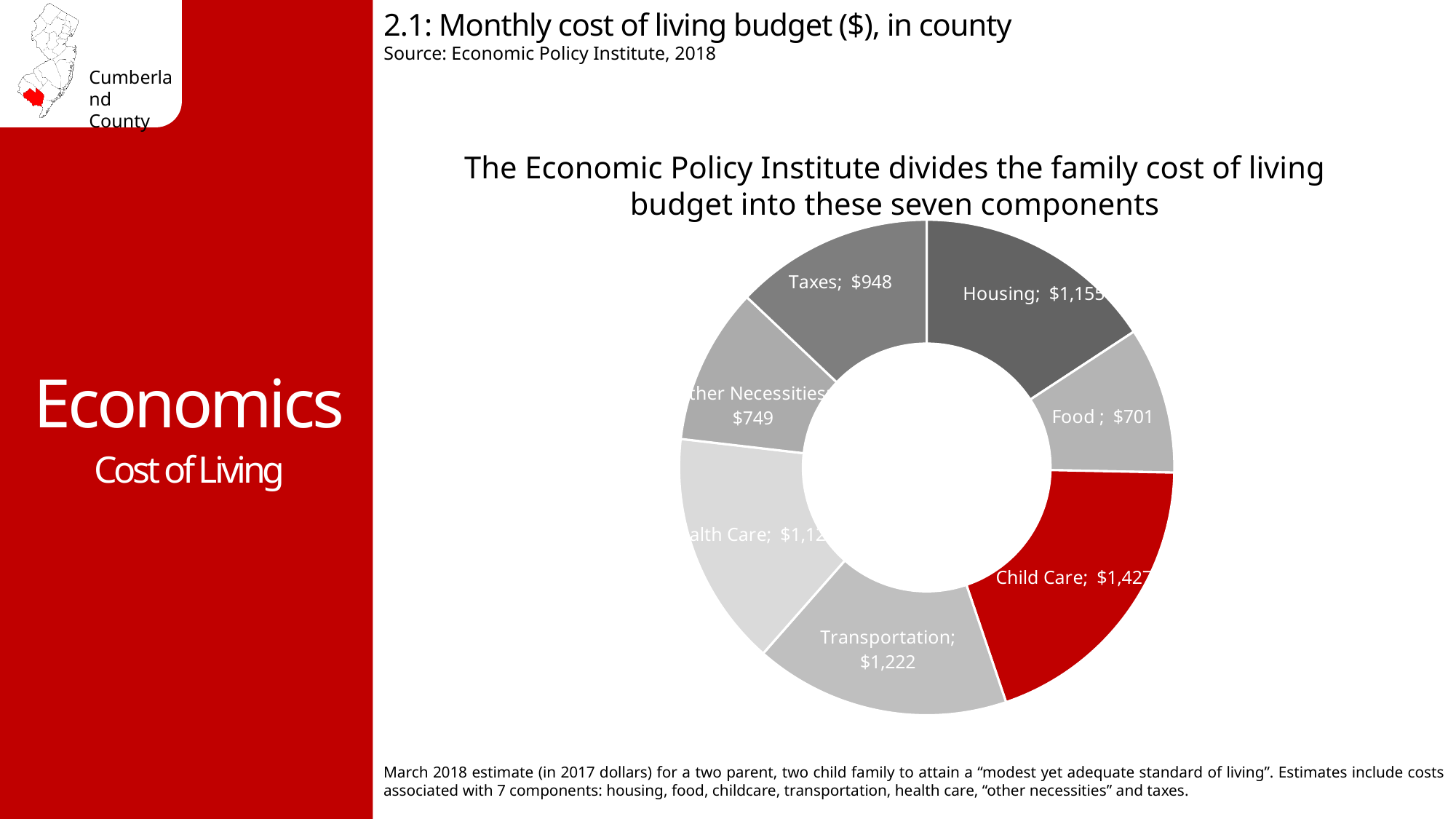
What is the monthly cost for Child Care? $1,427 What type of chart is shown on the slide? Doughnut (pie) chart Which component has the smallest monthly cost? Food What is the difference between the Transportation cost and the Taxes cost? $274 Which slice of the chart is coloured red? Child Care What is the monthly cost for Food? $701 How many components (slices) does the chart show? 7 Which component has the largest monthly cost? Child Care Which is larger, the cost for Taxes or the cost for Other Necessities? Taxes What is the monthly cost for Other Necessities? $749 What is the monthly cost for Transportation? $1,222 What is the monthly cost for Taxes? $948